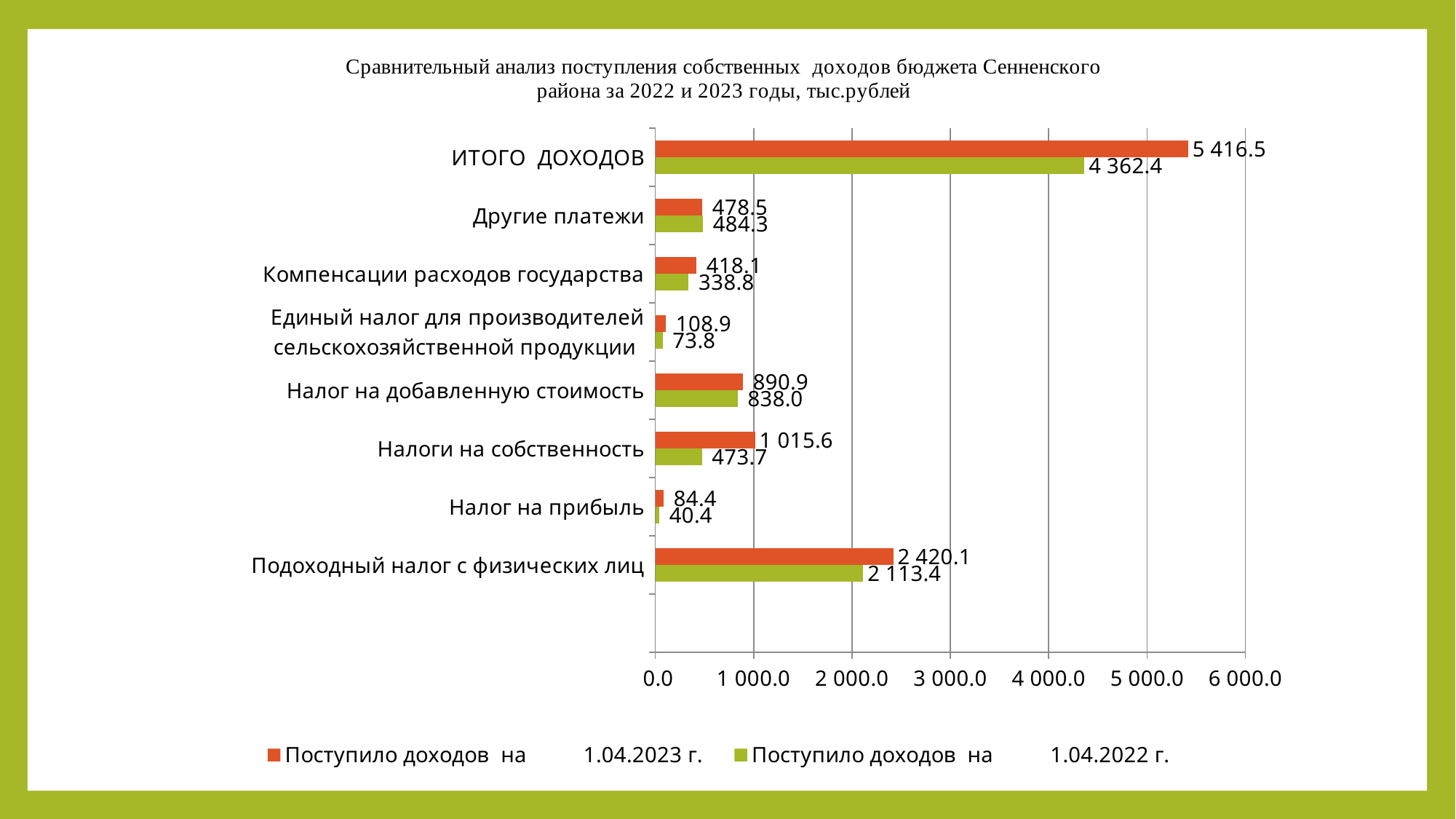
What is the value for Налог на прибыль in the series Поступило доходов на 1.04.2023 г.? 84.4 What is the value for Налоги на собственность in the series Поступило доходов на 1.04.2022 г.? 473.7 What is the value for ИТОГО ДОХОДОВ in the series Поступило доходов на 1.04.2022 г.? 4 362.4 How many series does the legend list? 2 Which category has the lowest value in the series Поступило доходов на 1.04.2022 г.? Налог на прибыль For Другие платежи, which series has the larger value: 1.04.2023 г. or 1.04.2022 г.? Поступило доходов на 1.04.2022 г. Excluding ИТОГО ДОХОДОВ, which category has the highest value in the series Поступило доходов на 1.04.2023 г.? Подоходный налог с физических лиц What is the difference between the 1.04.2023 г. and 1.04.2022 г. values for Налоги на собственность? 541.9 What kind of chart is shown on the slide? Bar chart What is the value for Подоходный налог с физических лиц in the series Поступило доходов на 1.04.2023 г.? 2 420.1 What is the difference between the 1.04.2023 г. and 1.04.2022 г. values for ИТОГО ДОХОДОВ? 1 054.1 How many categories are shown on the chart? 8